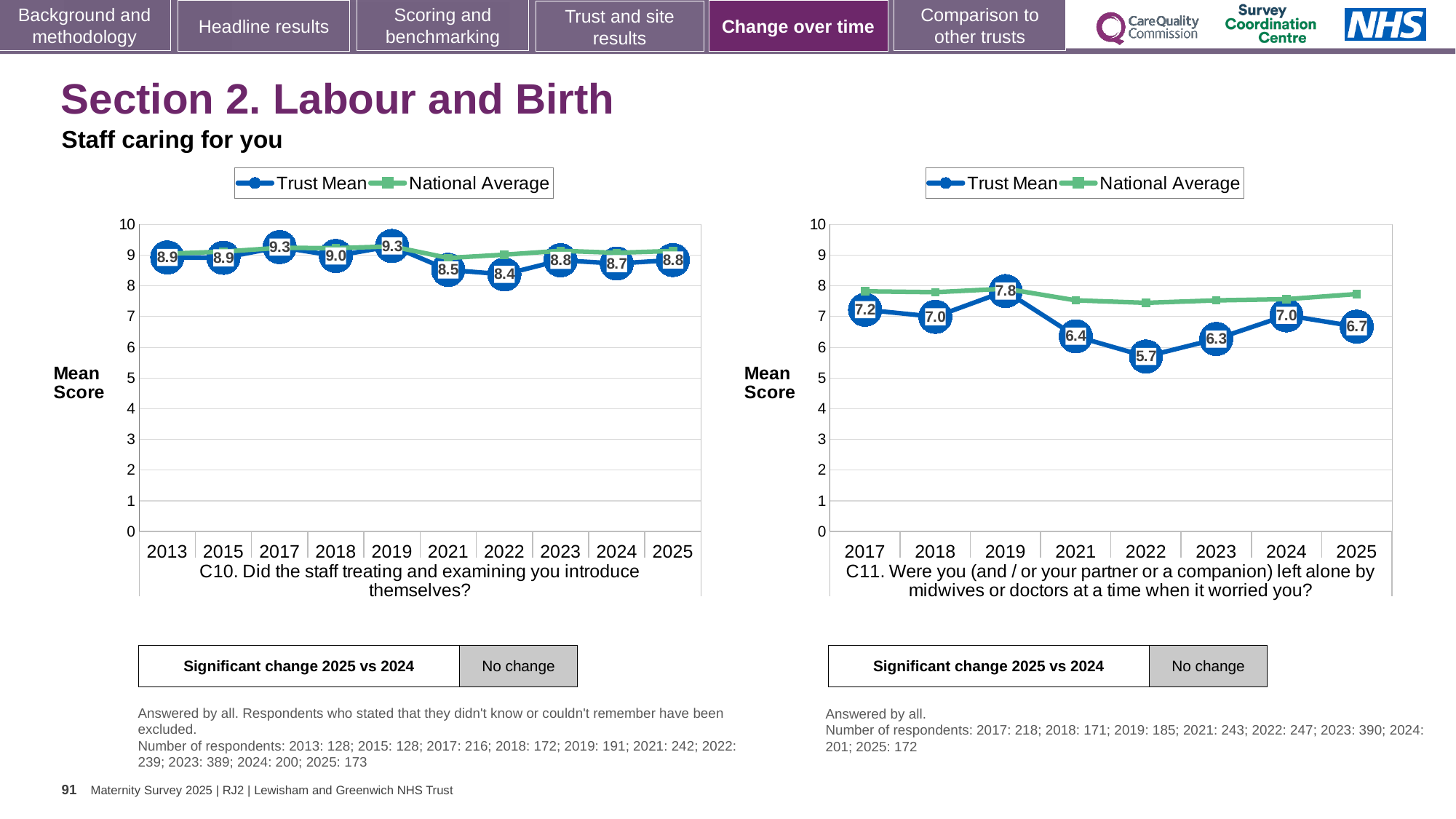
How many series does the legend of the right chart (C11) list? 2 In the left chart (C10), what is the difference between the Trust Mean scores for 2019 and 2022? 0.9 In the left chart (C10), which year has the lowest Trust Mean score? 2022 In the right chart (C11), is the National Average for 2022 greater or less than 7? greater In the right chart (C11), what is the difference between the Trust Mean scores for 2019 and 2025? 1.1 In the left chart (C10), how many years are shown on the x axis? 10 In the left chart (C10), what is the Trust Mean score for 2022? 8.4 In the right chart (C11), which year has the highest Trust Mean score? 2019 In the right chart (C11), is the Trust Mean score for 2024 greater or less than the National Average for 2024? less In the left chart (C10), what is the Trust Mean score for 2025? 8.8 In the right chart (C11), which year has the lowest Trust Mean score? 2022 In the right chart (C11), what is the Trust Mean score for 2022? 5.7